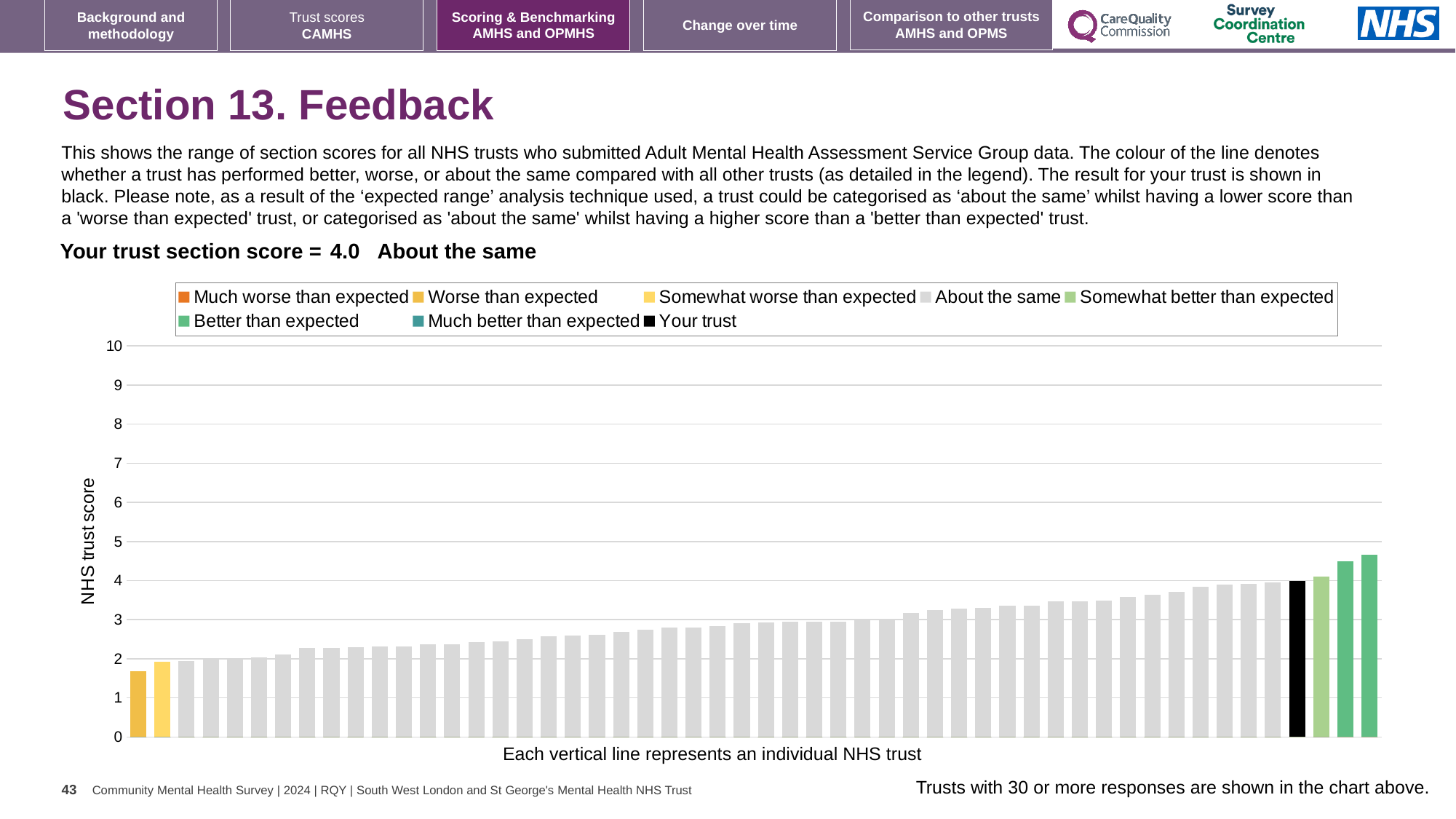
What is the label on the vertical axis? NHS trust score Is the value of the leftmost bar greater or less than 2? less What is the section score for your trust? 4.0 Is the value for your trust greater or less than 5? less How many categories does the chart legend list? 8 Is the value for your trust greater or less than 3? greater Which is larger: the value for your trust or the value of the leftmost bar? Your trust Do the bar values rise or fall from left to right along the x axis? Rise What kind of chart is shown on the slide? Bar chart What colour is the bar representing your trust? Black How many bars are coloured green (better than expected categories)? 3